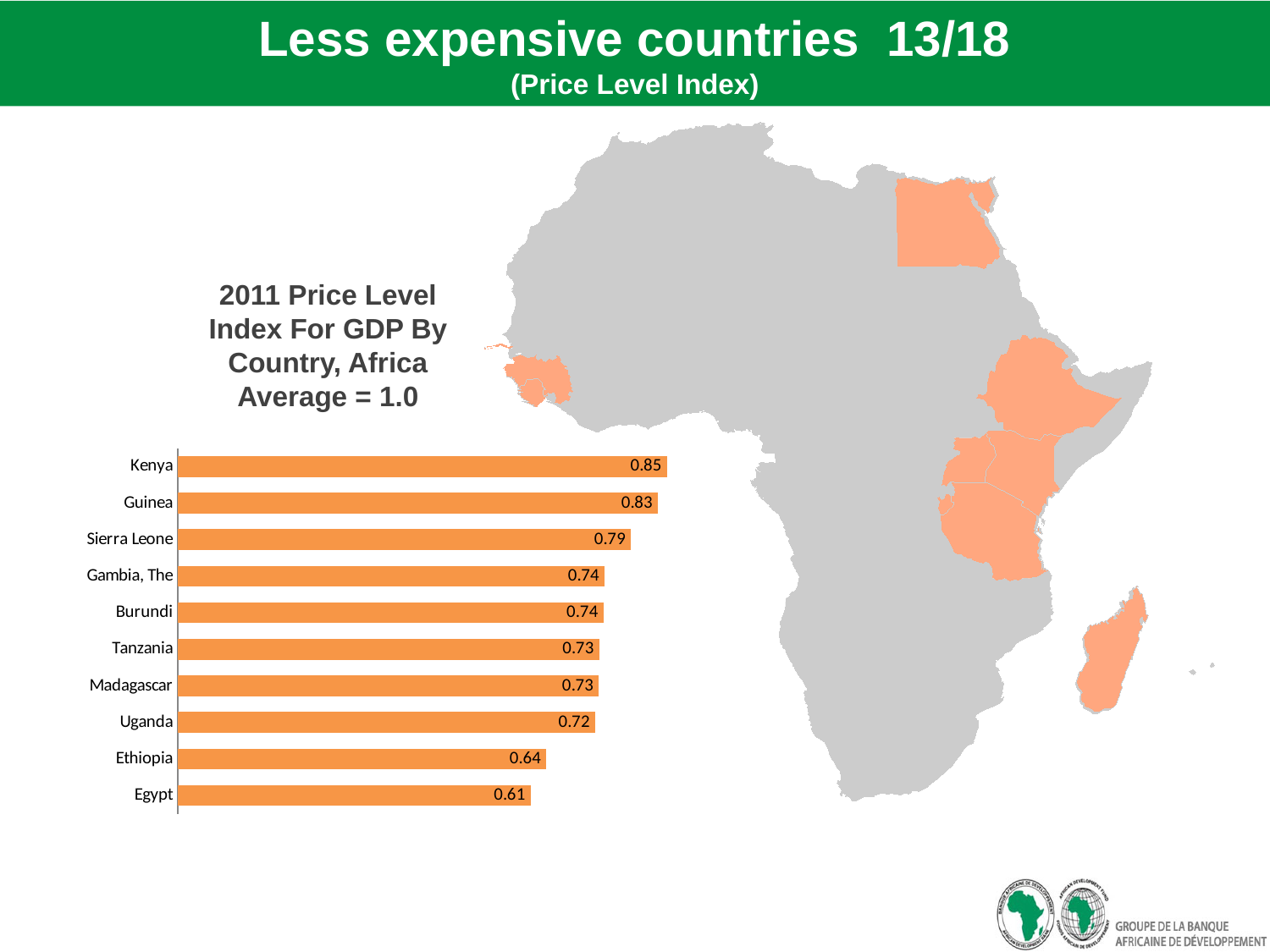
What is the title of the chart? 2011 Price Level Index For GDP By Country, Africa Average = 1.0 How many countries are shown on the bar chart? 10 What is the price level index value for Kenya? 0.85 Which country has the highest price level index on the chart? Kenya What type of chart is used to show the price level index values? Bar chart Which country has the lowest price level index on the chart? Egypt What is the price level index value for Egypt? 0.61 What is the difference between the price level index of Kenya and Egypt? 0.24 Which has a higher price level index, Sierra Leone or Uganda? Sierra Leone What is the price level index value for Sierra Leone? 0.79 What is the price level index value for Uganda? 0.72 What is the difference between the price level index of Guinea and Ethiopia? 0.19